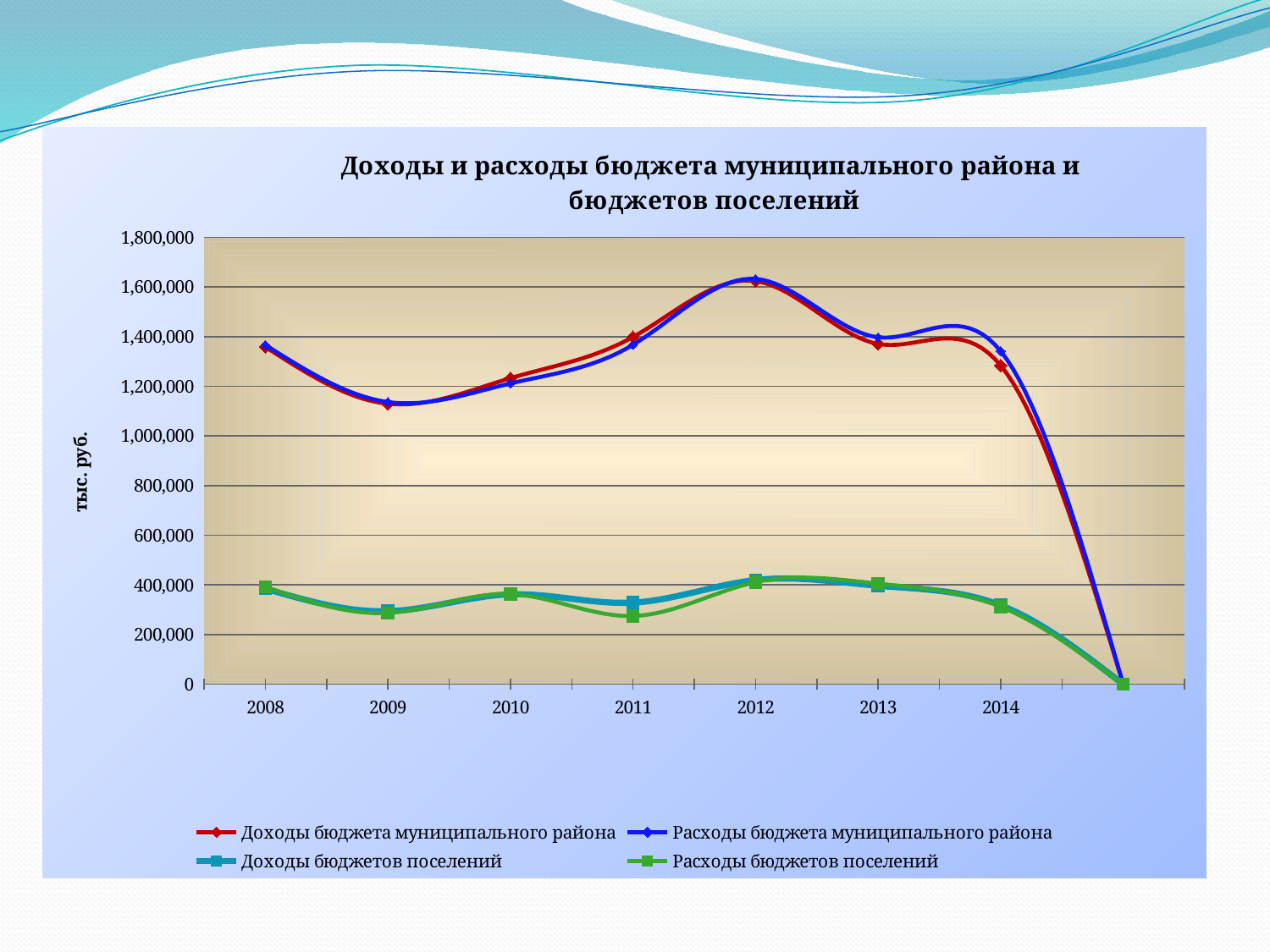
What is the title of the chart? Доходы и расходы бюджета муниципального района и бюджетов поселений Does the value for Доходы бюджета муниципального района rise or fall from 2009 to 2012? rise In which labeled year is the value for Доходы бюджета муниципального района highest? 2012 Is the value for Доходы бюджета муниципального района in 2012 greater or less than 1,400,000? greater What kind of chart is shown on the slide? line chart What is the label on the vertical axis? тыс. руб. Is the value for Доходы бюджета муниципального района in 2009 greater or less than 1,200,000? less Is the value for Расходы бюджетов поселений in 2009 greater or less than 400,000? less In 2011, which is larger: Доходы бюджетов поселений or Расходы бюджетов поселений? Доходы бюджетов поселений How many series does the legend list? 4 Among the labeled years 2008–2014, in which year is the value for Расходы бюджета муниципального района lowest? 2009 How many years are labeled on the x axis? 7